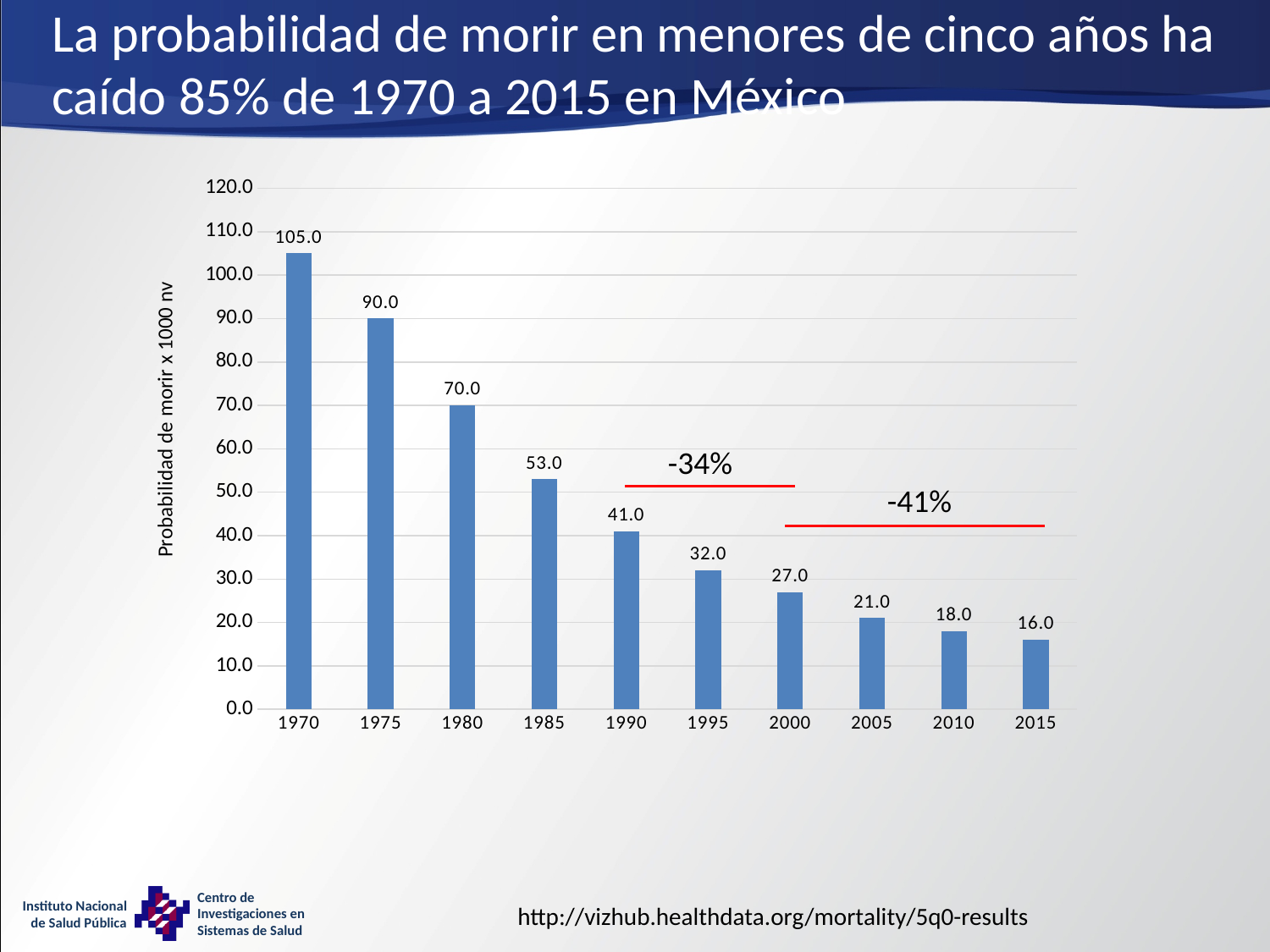
What kind of chart is this? bar chart What is the value for 2015? 16.0 What is the y-axis label of the chart? Probabilidad de morir x 1000 nv What is the value for 1970? 105.0 Which is larger, the value for 1990 or the value for 2000? 1990 What is the value for 1995? 32.0 Do the values rise or fall from 1970 to 2015? fall What is the difference between the values for 1980 and 1985? 17.0 Which year has the lowest value? 2015 What is the difference between the values for 1970 and 2015? 89.0 How many years are shown on the x axis? 10 Which year has the highest value? 1970